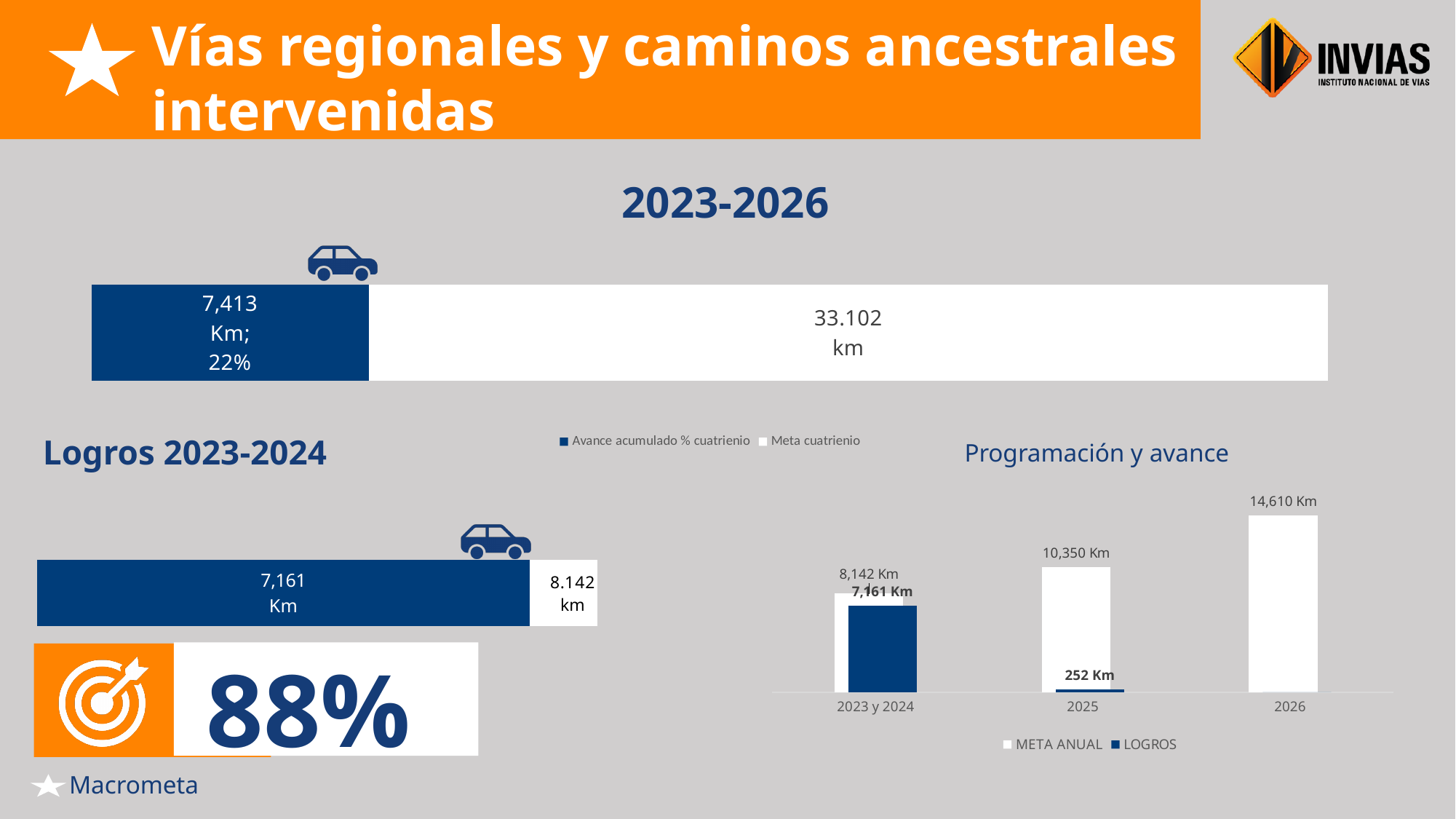
In the 'Logros 2023-2024' chart, what is the value of the white bar segment? 8.142 km In the 'Programación y avance' chart, how many periods are shown on the x axis? 3 In the 'Programación y avance' chart, what is the LOGROS value for 2023 y 2024? 7,161 Km In the 'Programación y avance' chart, how many series does the legend list? 2 In the 'Programación y avance' chart, which period has the highest META ANUAL? 2026 In the 'Programación y avance' chart, what is the LOGROS value for 2025? 252 Km In the 'Programación y avance' chart, what is the META ANUAL value for 2025? 10,350 Km In the '2023-2026' chart at the top, what is the 'Meta cuatrienio' value? 33.102 km What kind of chart is 'Programación y avance'? bar chart In the '2023-2026' chart at the top, what is the value labelled for 'Avance acumulado % cuatrienio'? 7,413 Km; 22% In the 'Programación y avance' chart, what is the META ANUAL value for 2026? 14,610 Km In the 'Programación y avance' chart, does the META ANUAL rise or fall from 2023 y 2024 to 2026? rise